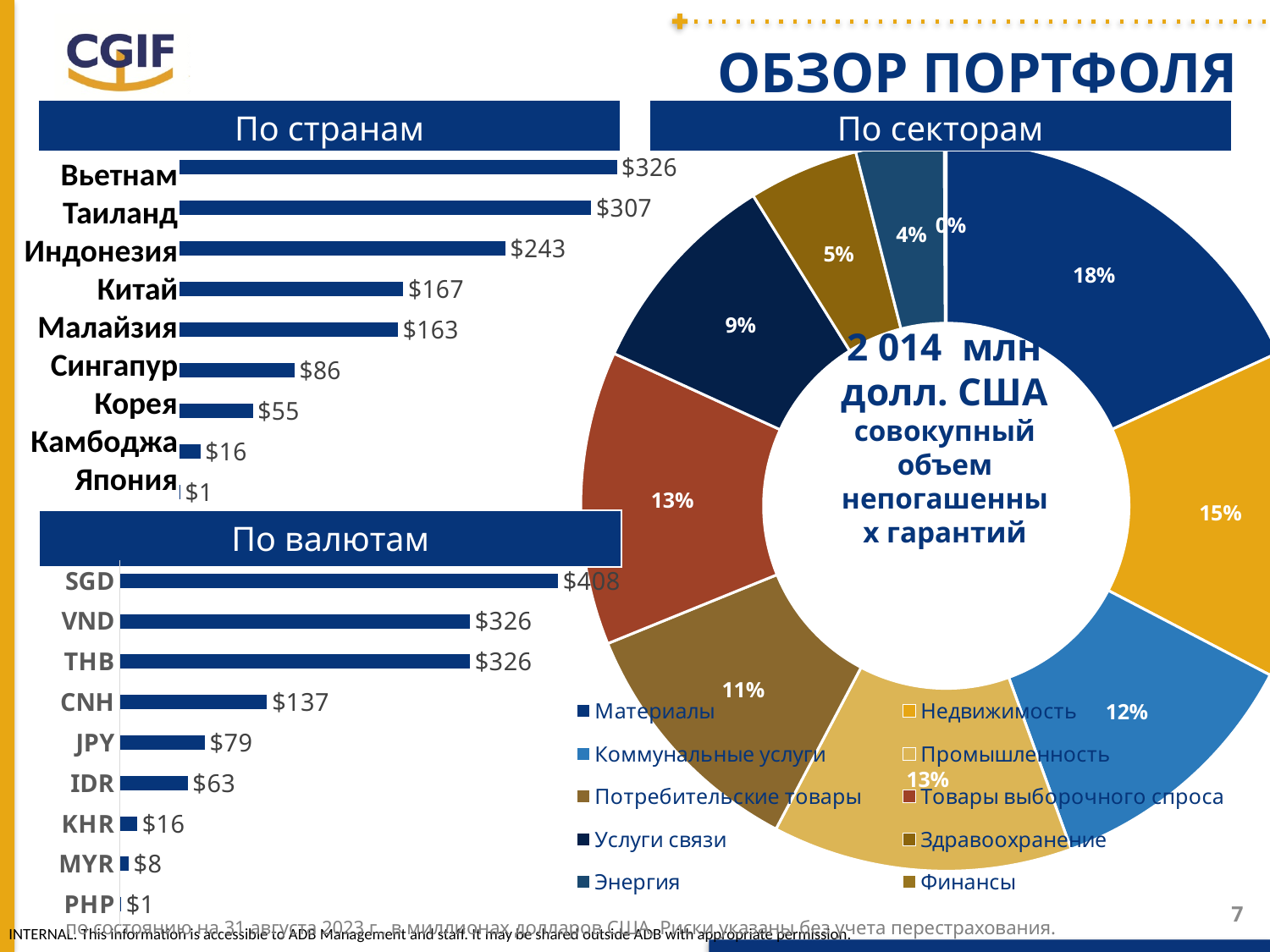
How many entries does the legend of the 'По секторам' chart list? 10 In the 'По странам' chart, what is the difference between Таиланд and Индонезия? $64 In the 'По валютам' chart, which currency has the highest value? SGD In the 'По странам' chart, which is larger, Китай or Малайзия? Китай What total amount is shown in the centre of the 'По секторам' chart? 2 014 млн долл. США In the 'По валютам' chart, what is the value for IDR? $63 In the 'По валютам' chart, what is the value for SGD? $408 In the 'По валютам' chart, what is the difference between CNH and JPY? $58 In the 'По странам' chart, which country has the lowest value? Япония What kind of chart is the 'По секторам' chart? Doughnut (pie) chart How many countries are shown in the 'По странам' chart? 9 In the 'По странам' chart, what is the value for Вьетнам? $326